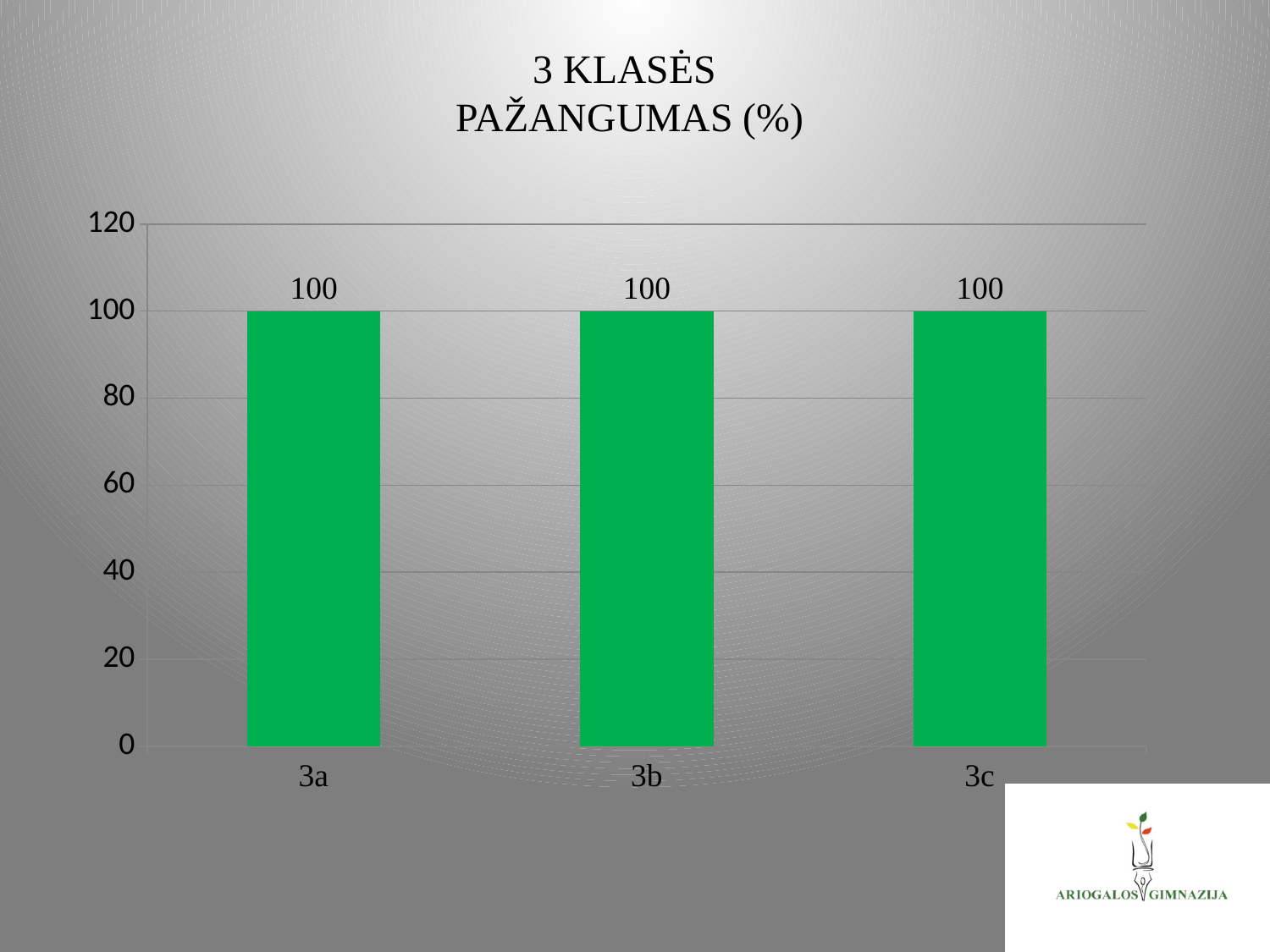
How many categories are shown on the x axis? 3 What is the title of the chart? 3 KLASĖS PAŽANGUMAS (%) What is the value for 3c? 100 What colour are the bars in the chart? green What kind of chart is shown on the slide? bar chart Is the value for 3b greater or less than 80? greater What is the value for 3b? 100 What is the value for 3a? 100 Do the values rise, fall or stay the same from 3a to 3c? stay the same What is the difference between the values for 3a and 3c? 0 What is the highest value shown on the y axis? 120 Is the value for 3c greater or less than 120? less